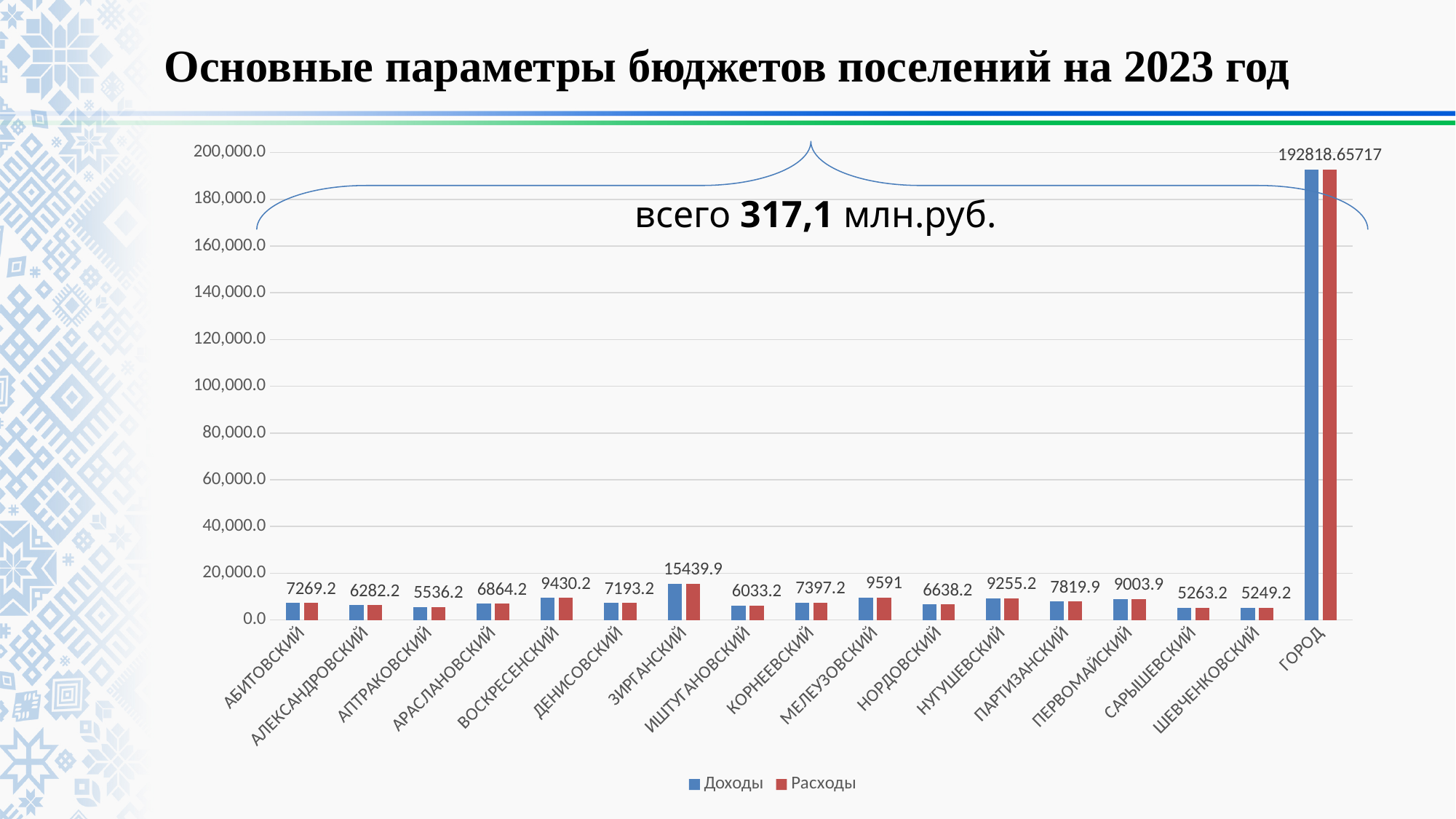
How many categories (settlements) are shown on the x axis? 17 What are the two series named in the legend? Доходы and Расходы Which category has the highest value? ГОРОД What data label is shown for ГОРОД? 192818.65717 What data label is shown for АБИТОВСКИЙ? 7269.2 What total amount is stated in the text above the chart? всего 317,1 млн.руб. How many series does the legend list? 2 Which has the larger labelled value, ВОСКРЕСЕНСКИЙ or МЕЛЕУЗОВСКИЙ? МЕЛЕУЗОВСКИЙ What data label is shown for ЗИРГАНСКИЙ? 15439.9 Which category has the lowest labelled value? ШЕВЧЕНКОВСКИЙ What is the difference between the labelled values for ЗИРГАНСКИЙ and АБИТОВСКИЙ? 8170.7 What kind of chart is shown on the slide? bar chart